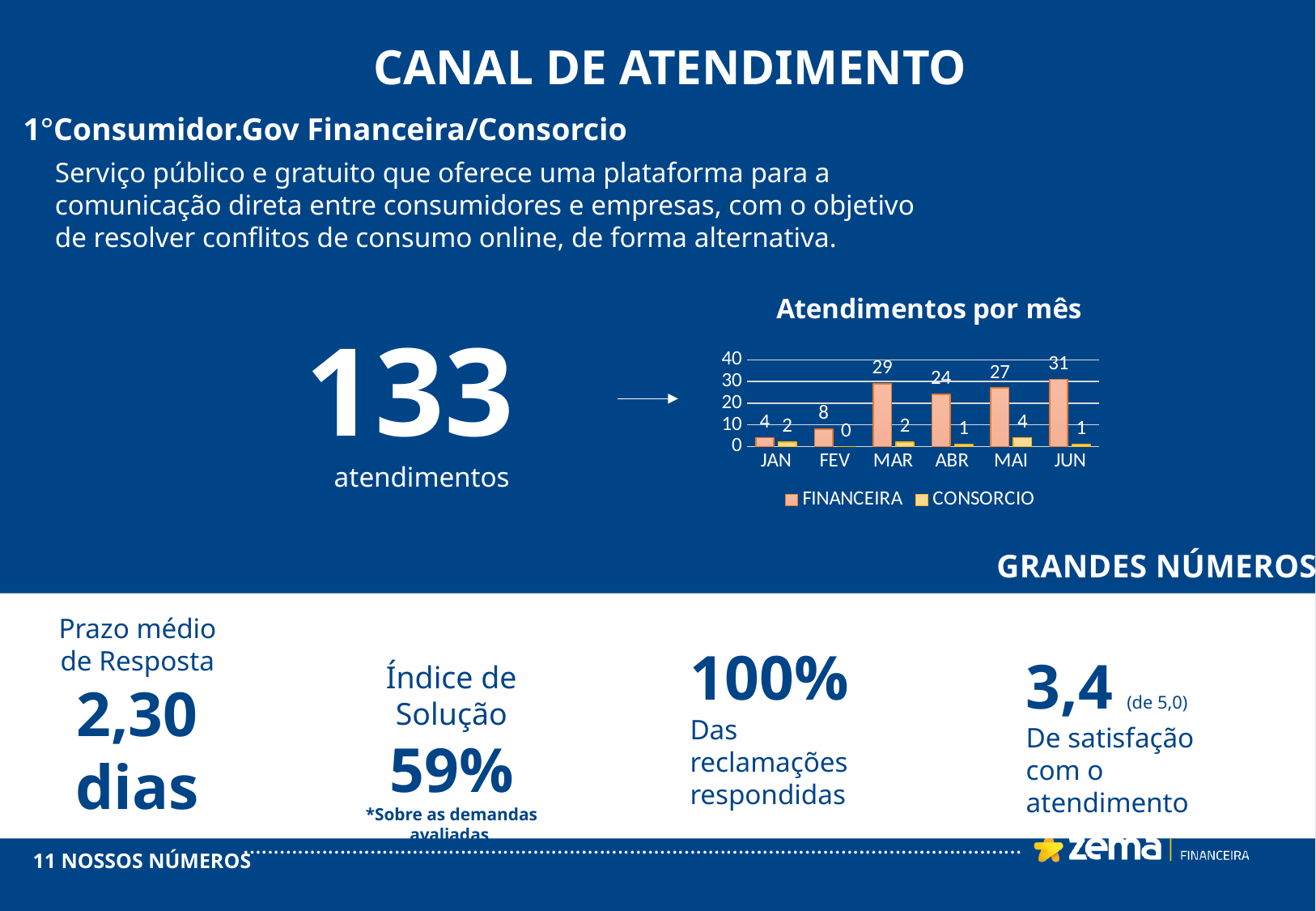
What kind of chart is 'Atendimentos por mês'? bar chart What is the value for FINANCEIRA in MAR in the 'Atendimentos por mês' chart? 29 Which month has the lowest CONSORCIO value in the 'Atendimentos por mês' chart? FEV How many months are shown on the x axis of the 'Atendimentos por mês' chart? 6 In the 'Atendimentos por mês' chart, is the FINANCEIRA value for MAR or MAI larger? MAR What is the value for FINANCEIRA in JAN in the 'Atendimentos por mês' chart? 4 How many series does the legend of the 'Atendimentos por mês' chart list? 2 Which month has the highest FINANCEIRA value in the 'Atendimentos por mês' chart? JUN Is the FINANCEIRA value for FEV greater or less than 10 in the 'Atendimentos por mês' chart? less What is the value for CONSORCIO in MAI in the 'Atendimentos por mês' chart? 4 What is the total of FINANCEIRA and CONSORCIO for JAN in the 'Atendimentos por mês' chart? 6 What is the difference between the FINANCEIRA values for JUN and ABR in the 'Atendimentos por mês' chart? 7